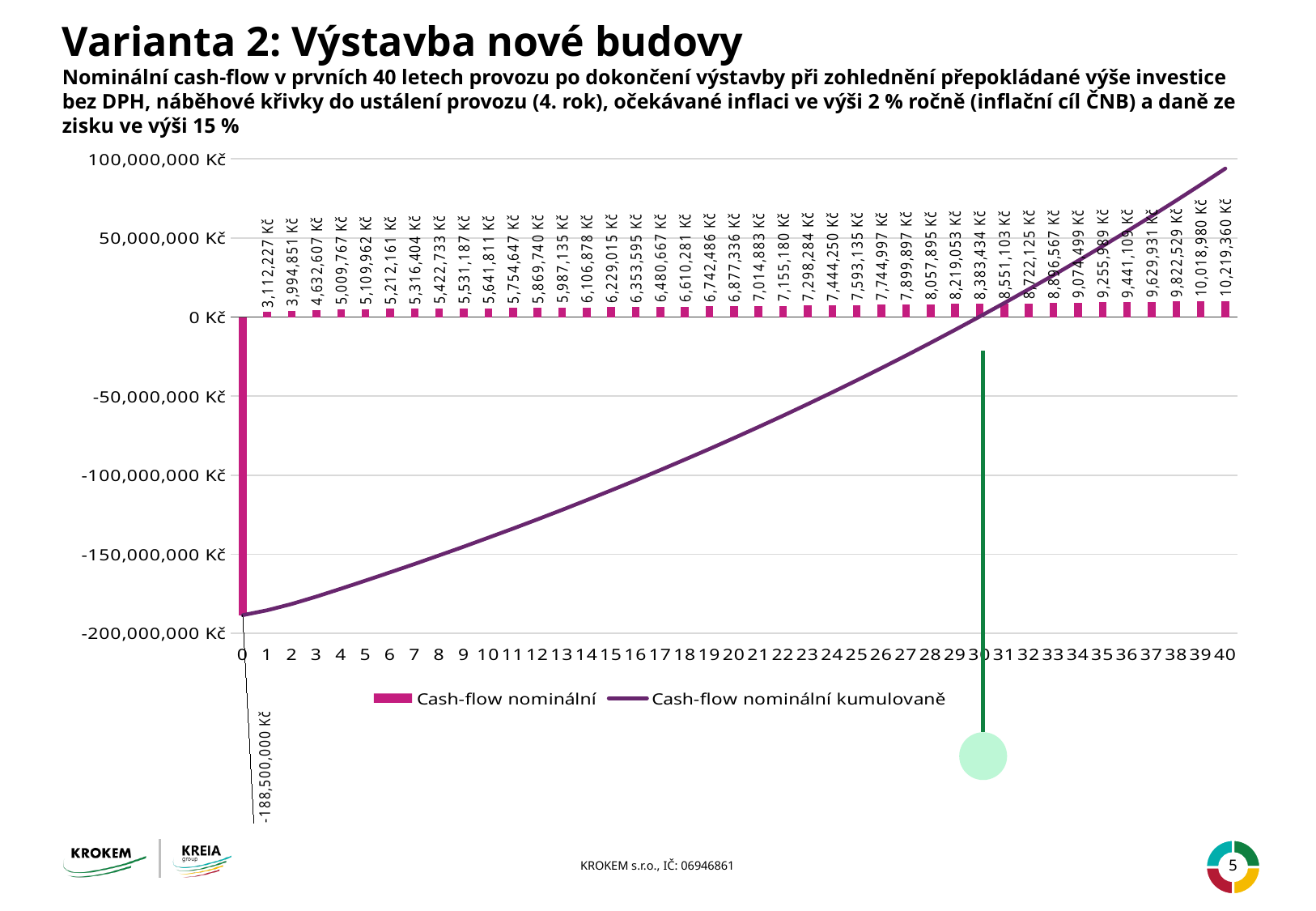
What is the value of the Cash-flow nominální bar for year 30? 8,383,434 Kč What is the difference between the Cash-flow nominální values for year 2 and year 1? 882,624 Kč What is the value of the Cash-flow nominální bar for year 40? 10,219,360 Kč How many series does the legend list? 2 What is the value of the Cash-flow nominální bar for year 1? 3,112,227 Kč What colour are the Cash-flow nominální bars? Pink/magenta Which year has the lowest Cash-flow nominální value? 0 What is the value of the Cash-flow nominální bar for year 20? 6,877,336 Kč Which year has the highest Cash-flow nominální value? 40 Does the Cash-flow nominální kumulovaně line rise or fall from year 0 to year 40? rise What is the value of the Cash-flow nominální bar for year 0? -188,500,000 Kč Is the Cash-flow nominální kumulovaně value at year 10 greater or less than -100,000,000 Kč? less